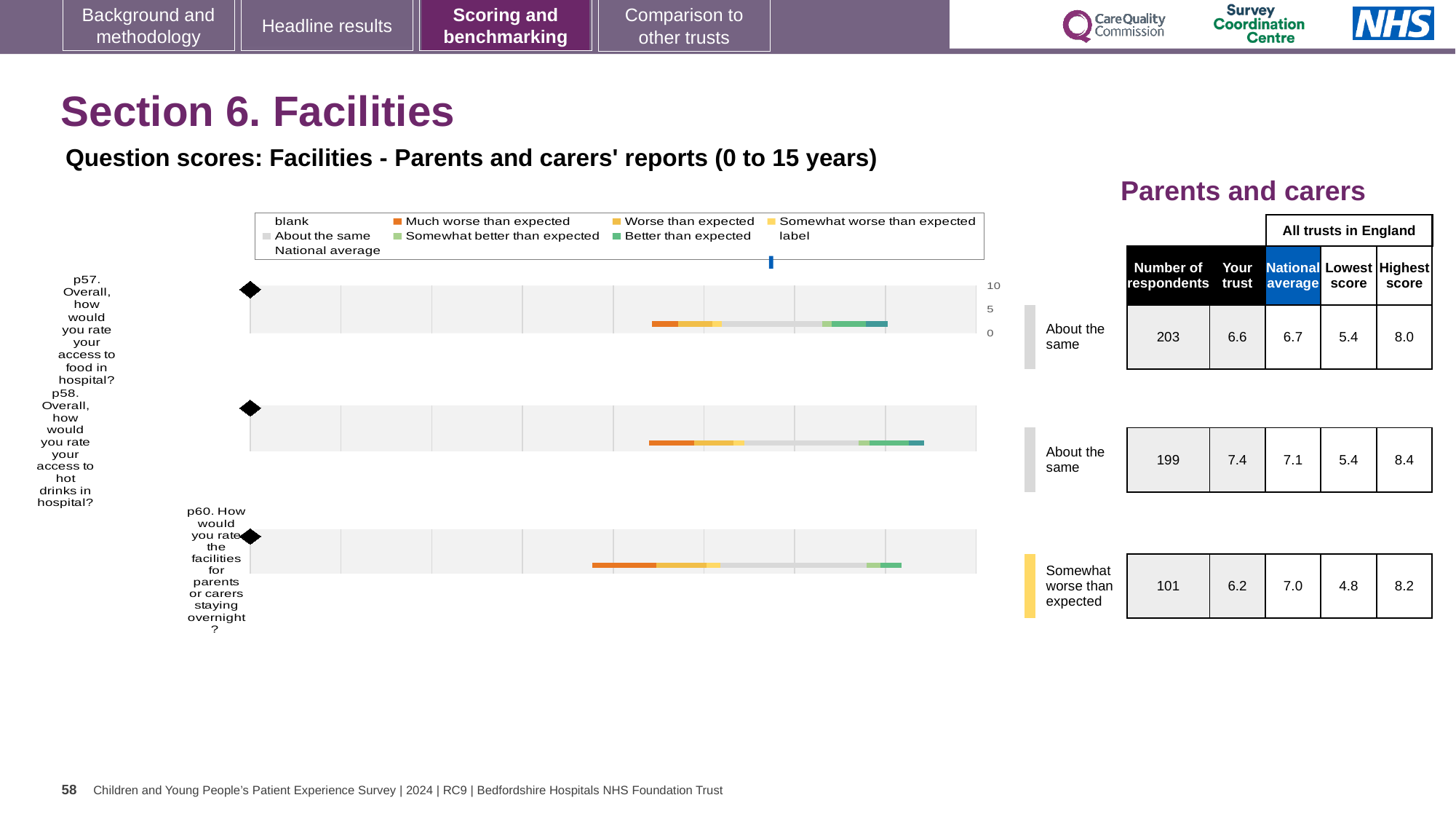
Which question has the fewest respondents? p60. How would you rate the facilities for parents or carers staying overnight? How many respondents answered p60 (facilities for parents or carers staying overnight)? 101 Which benchmark category does the chart's legend show in orange? Much worse than expected What is the title of the chart section shown above the bars? Question scores: Facilities - Parents and carers' reports (0 to 15 years) What is the national average score for p58 (access to hot drinks in hospital)? 7.1 What is the 'Your trust' score for p57 (access to food in hospital)? 6.6 Which question has the highest 'Your trust' score? p58. Overall, how would you rate your access to hot drinks in hospital? For p58, which is larger: the 'Your trust' score or the national average? Your trust How many questions (bars) are plotted in the chart? 3 What is the difference between the highest score and the lowest score for p58? 3.0 What is the benchmark rating shown for p60 (facilities for parents or carers staying overnight)? Somewhat worse than expected What kind of chart is shown on the slide? bar chart